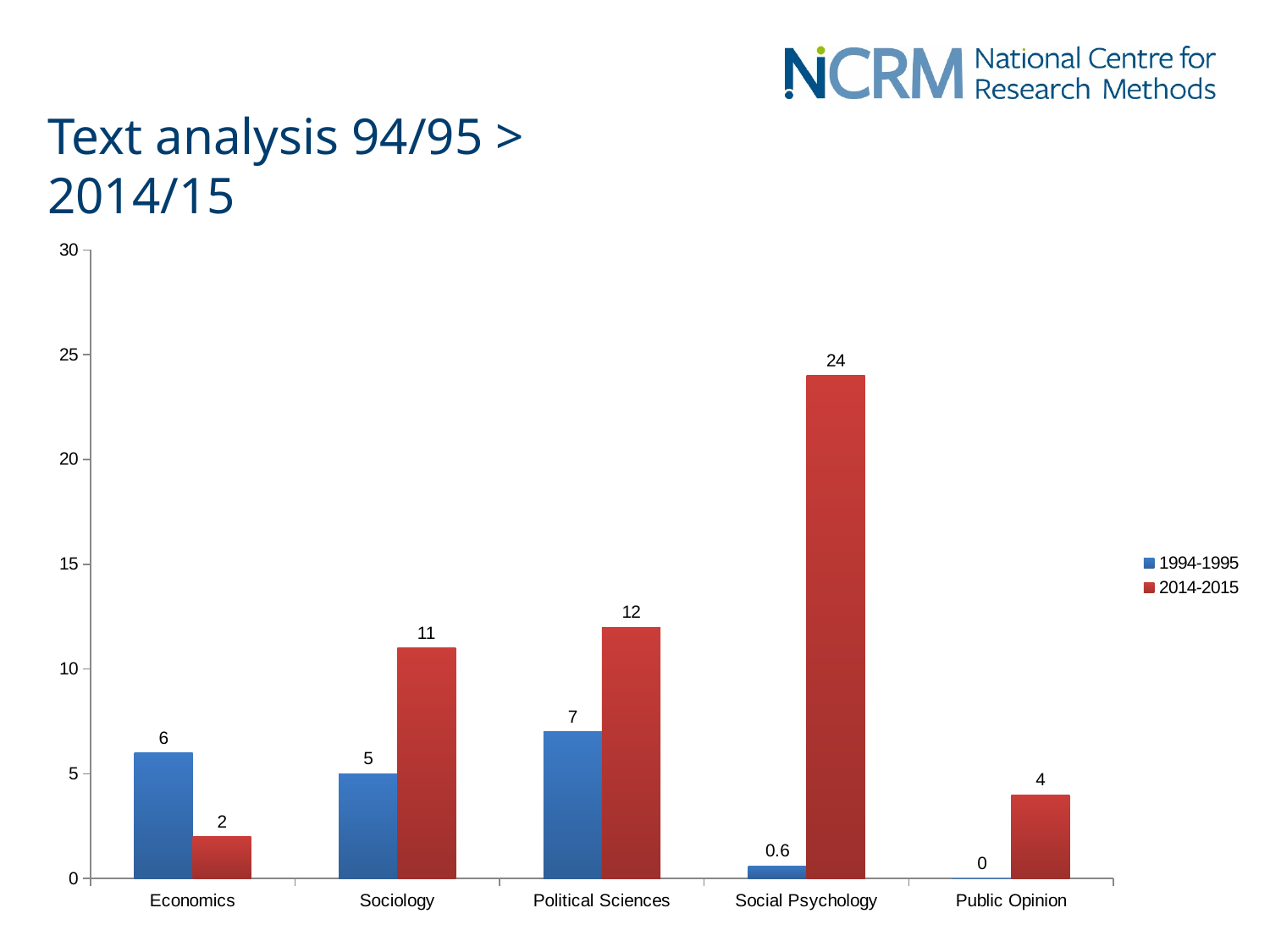
How many series does the legend list? 2 Which category has the lowest value in the 1994-1995 series? Public Opinion What is the value for Economics in the 1994-1995 series? 6 What is the value for Political Sciences in the 2014-2015 series? 12 Which category has the highest value in the 2014-2015 series? Social Psychology Which is larger for Economics: the 1994-1995 value or the 2014-2015 value? 1994-1995 What kind of chart is shown on the slide? Bar chart What is the value for Social Psychology in the 1994-1995 series? 0.6 What colour represents the 2014-2015 series? Red How many categories are shown on the x axis? 5 What is the value for Social Psychology in the 2014-2015 series? 24 What is the difference between the 2014-2015 and 1994-1995 values for Sociology? 6